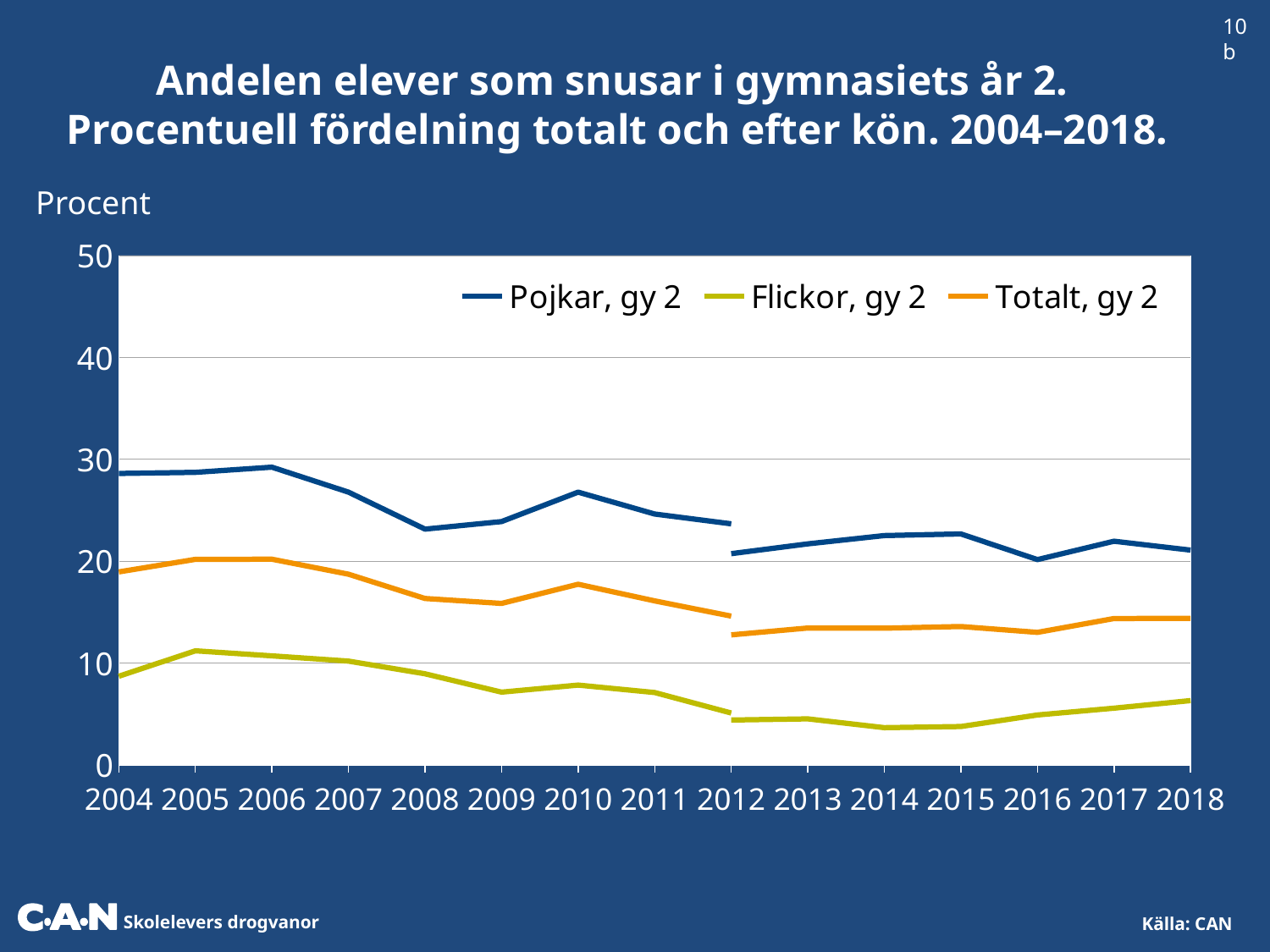
Is the value for Totalt, gy 2 in 2005 greater or less than 10? greater Is the value for Totalt, gy 2 in 2018 greater or less than 20? less Which series has the lowest values across all years? Flickor, gy 2 How many years are shown on the x axis? 15 What label is shown above the y axis? Procent How many series does the legend list? 3 In 2010, which is larger: Pojkar, gy 2 or Flickor, gy 2? Pojkar, gy 2 Is the value for Flickor, gy 2 in 2014 greater or less than 10? less Does the Pojkar, gy 2 line overall rise or fall from 2004 to 2018? fall Which series has the highest value in 2018? Pojkar, gy 2 What type of chart is shown on the slide? line chart